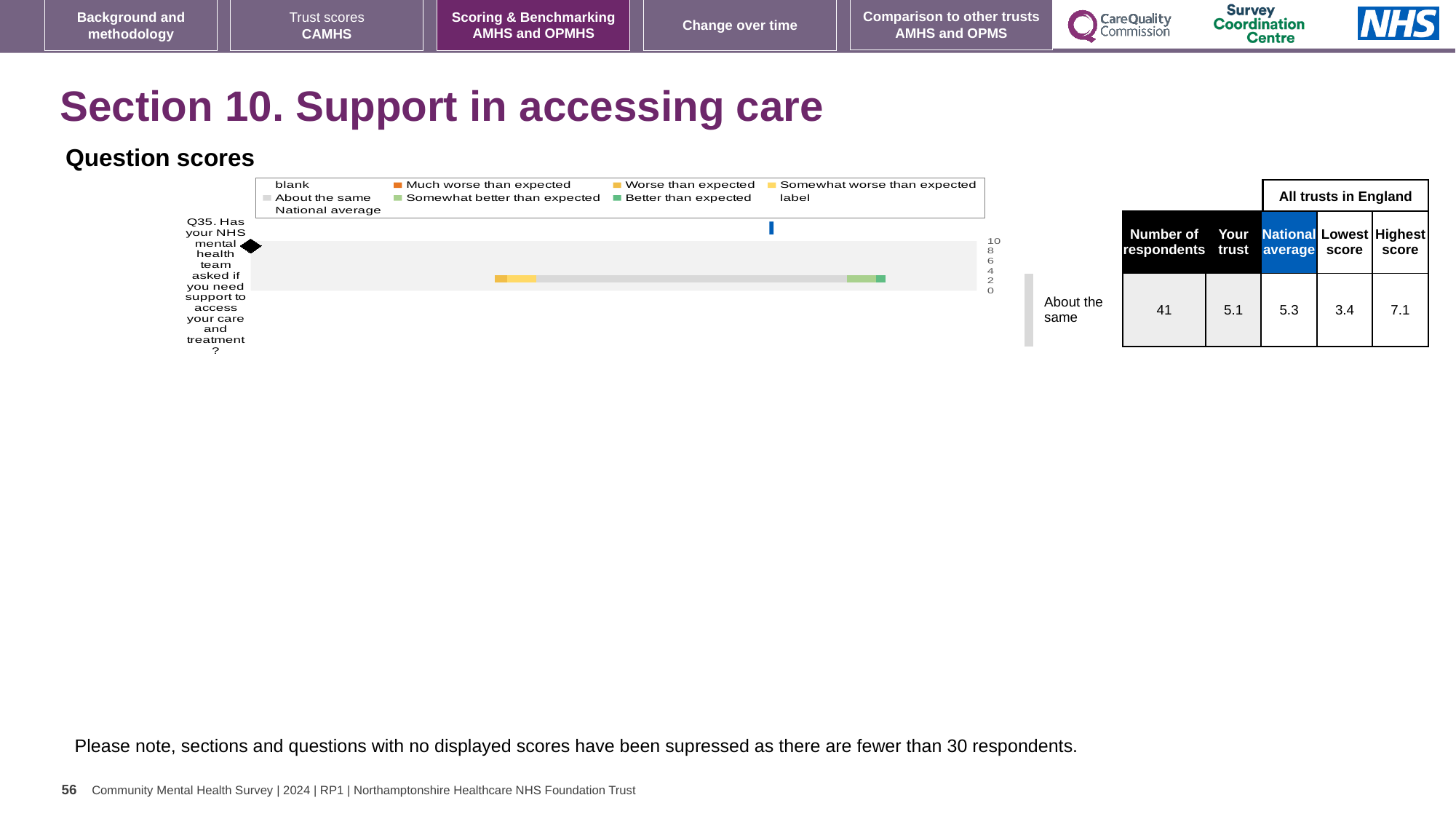
Which question is plotted in the Question scores chart? Q35. Has your NHS mental health team asked if you need support to access your care and treatment? What is the difference between the Highest score and the Lowest score for Q35? 3.7 What is the Lowest score among all trusts in England for Q35? 3.4 Which is larger for Q35, the Your trust score or the National average? National average How many entries does the legend of the Question scores chart list? 9 What is the "Your trust" score for Q35? 5.1 What is the National average score for Q35? 5.3 How many questions are plotted in the Question scores chart? 1 How many respondents answered Q35? 41 What kind of chart is shown under "Question scores"? bar chart What is the Highest score among all trusts in England for Q35? 7.1 What is the highest value shown on the axis of the Question scores chart? 10